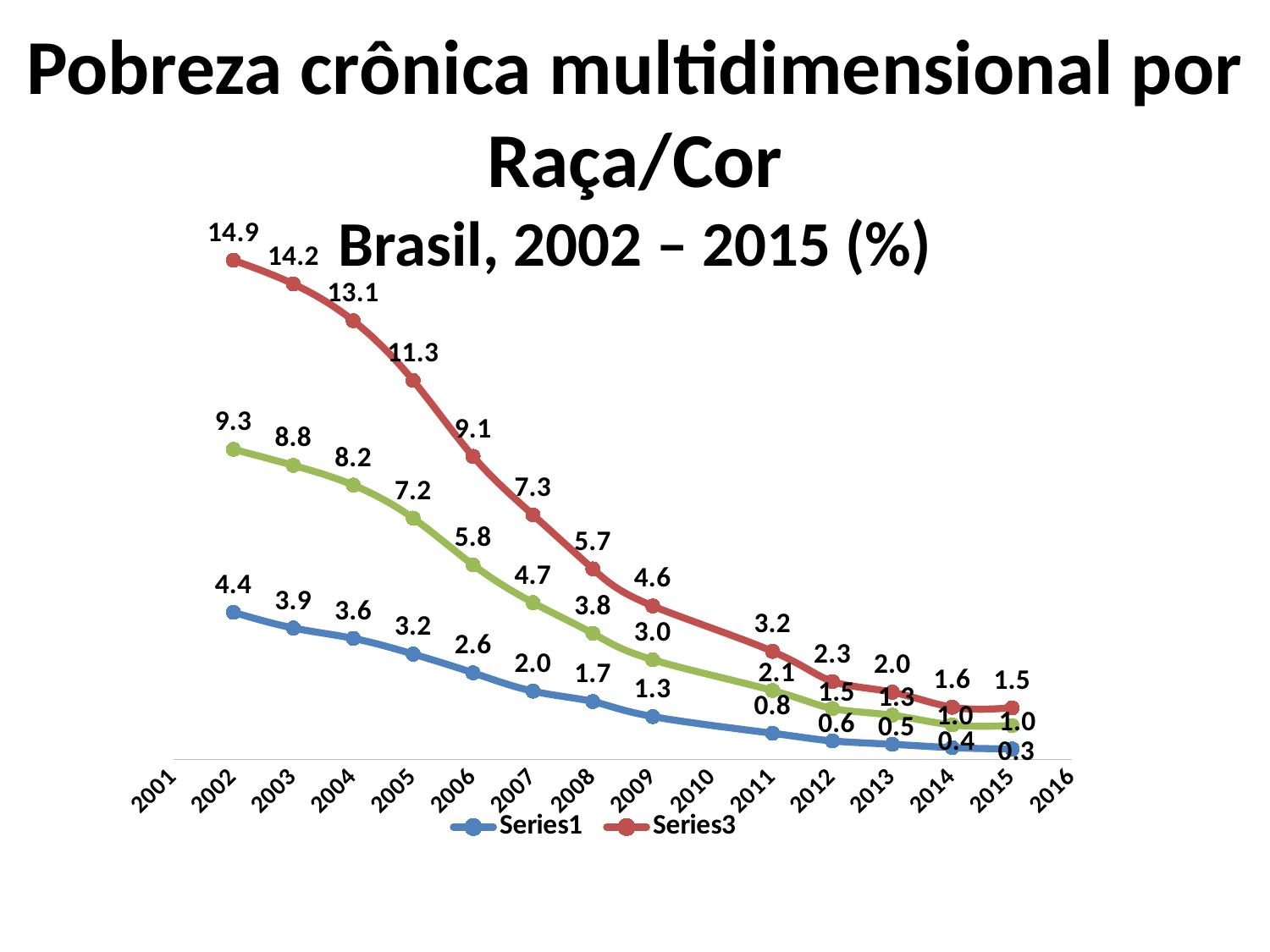
What is the value of Series1 in 2015? 0.3 Do the values of Series3 rise or fall from 2002 to 2015? Fall What is the value of Series3 in 2009? 4.6 What is the value of Series1 in 2006? 2.6 In which year does Series3 reach its highest value? 2002 How many series does the legend list? 2 What is the difference between the Series1 value in 2002 and its value in 2015? 4.1 In which year does Series1 reach its lowest value? 2015 What kind of chart is shown on the slide? Line chart What is the difference between the Series3 value in 2002 and its value in 2015? 13.4 Which is larger in 2012: the value of Series3 or the value of Series1? Series3 What is the value of Series3 in 2002? 14.9